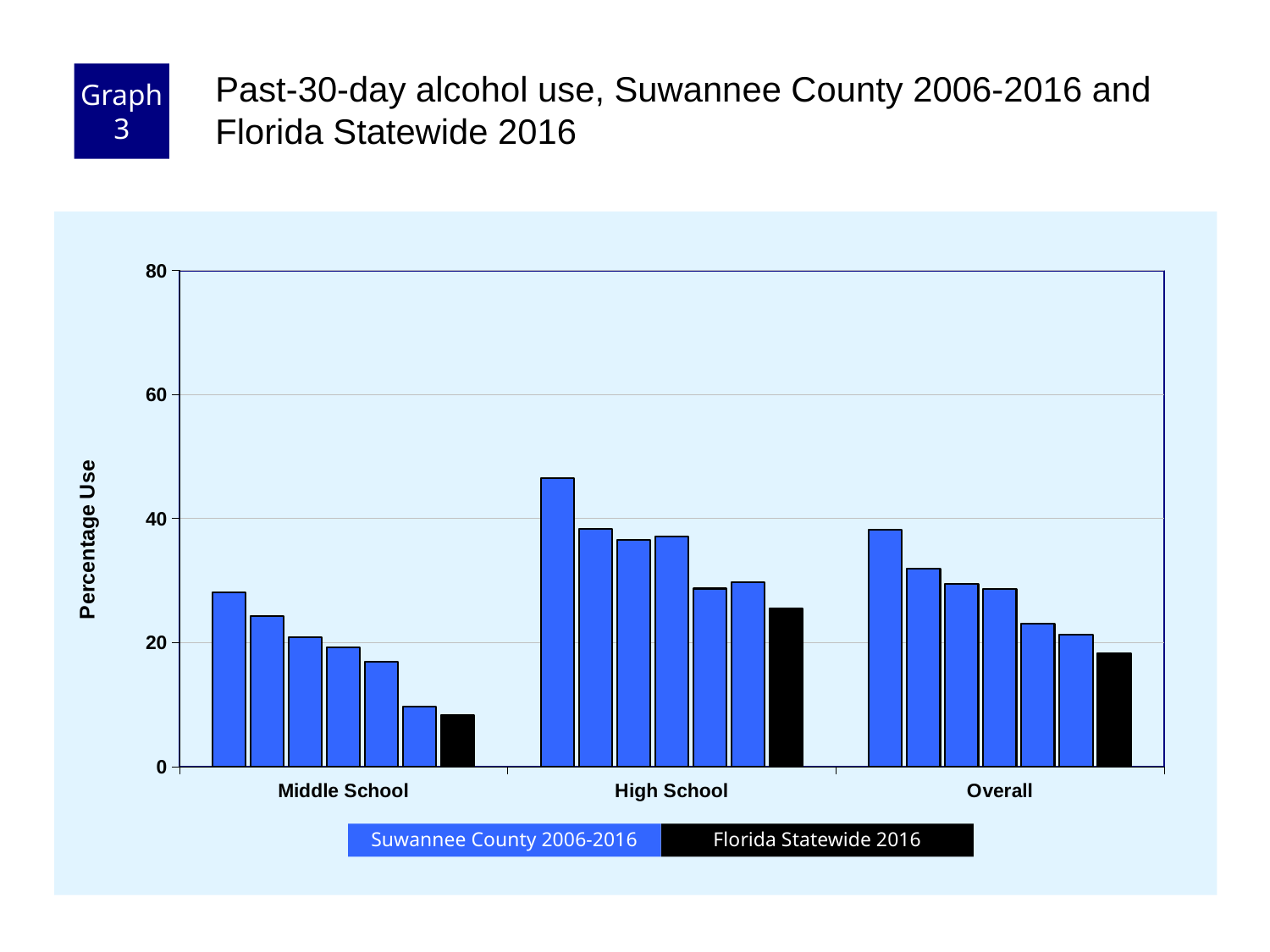
Is the tallest Suwannee County bar in the High School group greater or less than 40? greater Which category has the highest Florida Statewide 2016 value? High School How many categories are shown on the x axis? 3 What is the label on the y axis? Percentage Use Do the Suwannee County 2006-2016 bars in the Middle School group generally rise or fall from left to right? fall Is the Florida Statewide 2016 value for High School greater or less than 20? greater Which category has the lowest Florida Statewide 2016 value? Middle School What kind of chart is shown on the slide? bar chart What colour are the Florida Statewide 2016 bars? black How many series does the legend list? 2 Which is larger, the Florida Statewide 2016 value for High School or for Overall? High School Is the Florida Statewide 2016 value for Middle School greater or less than 20? less